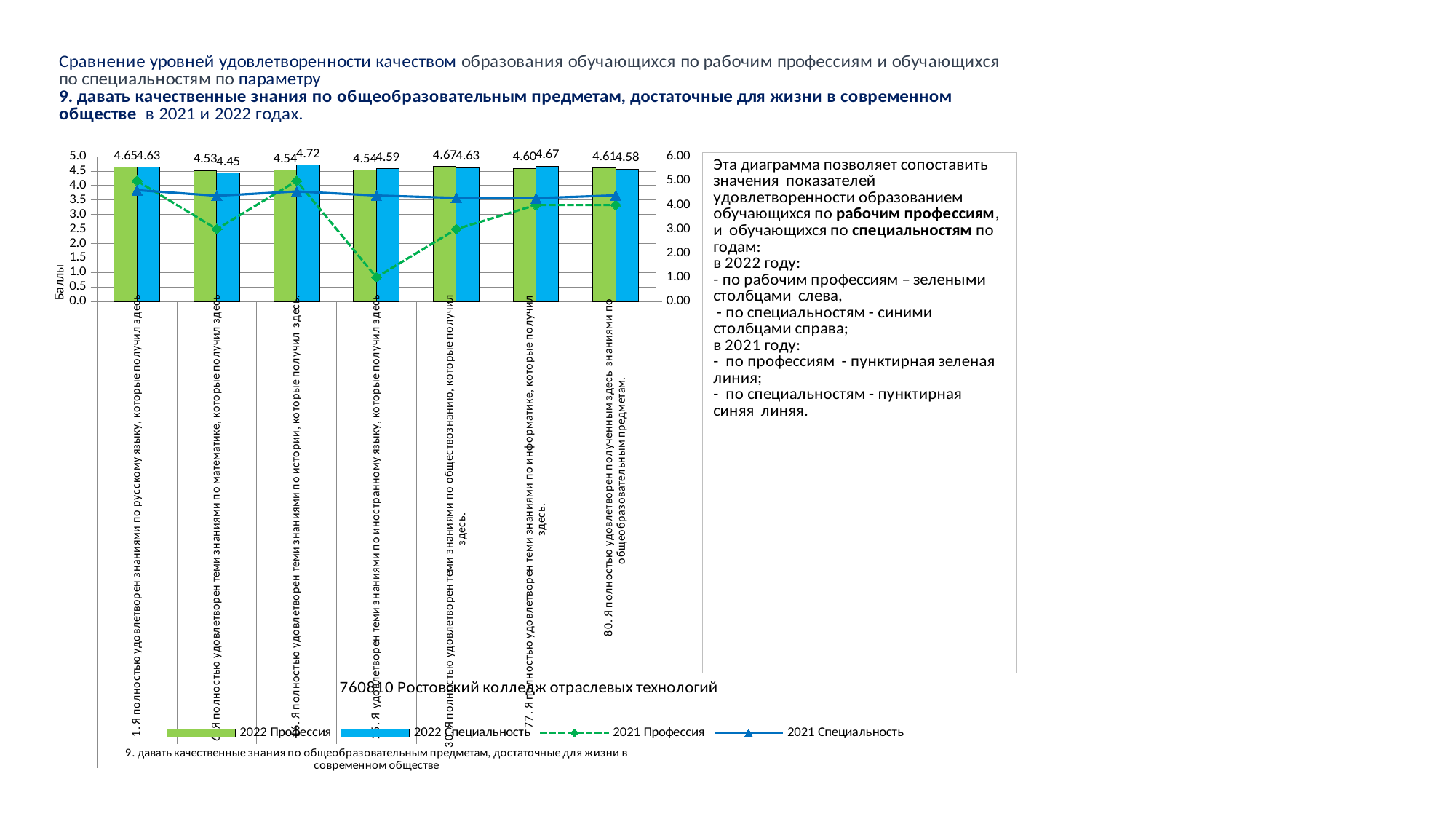
What is the value of the 2022 Специальность bar for the category about knowledge of история (history)? 4.72 What is the title of the vertical axis on the left of the chart? Баллы How many series does the chart legend list? 4 How many categories are shown on the x axis of the chart? 7 What is the value of the 2022 Профессия bar for the category about knowledge of русский язык (Russian language)? 4.65 For the информатика (informatics) category, which is larger: the 2022 Профессия bar or the 2022 Специальность bar? 2022 Специальность (4.67) Which category has the lowest 2022 Специальность bar? Я полностью удовлетворен теми знаниями по математике, которые получил здесь (4.45) What is the difference between the 2022 Специальность and 2022 Профессия values for the история (history) category? 0.18 What is the value of the 2022 Специальность bar for the category about knowledge of математика (mathematics)? 4.45 Is the 2021 Профессия line value for the иностранный язык (foreign language) category greater or less than 2.00 on the right axis? less Which category has the highest 2022 Специальность bar? Я полностью удовлетворен теми знаниями по истории, которые получил здесь (4.72) What is the value of the 2022 Профессия bar for the category about knowledge of обществознание (social studies)? 4.67